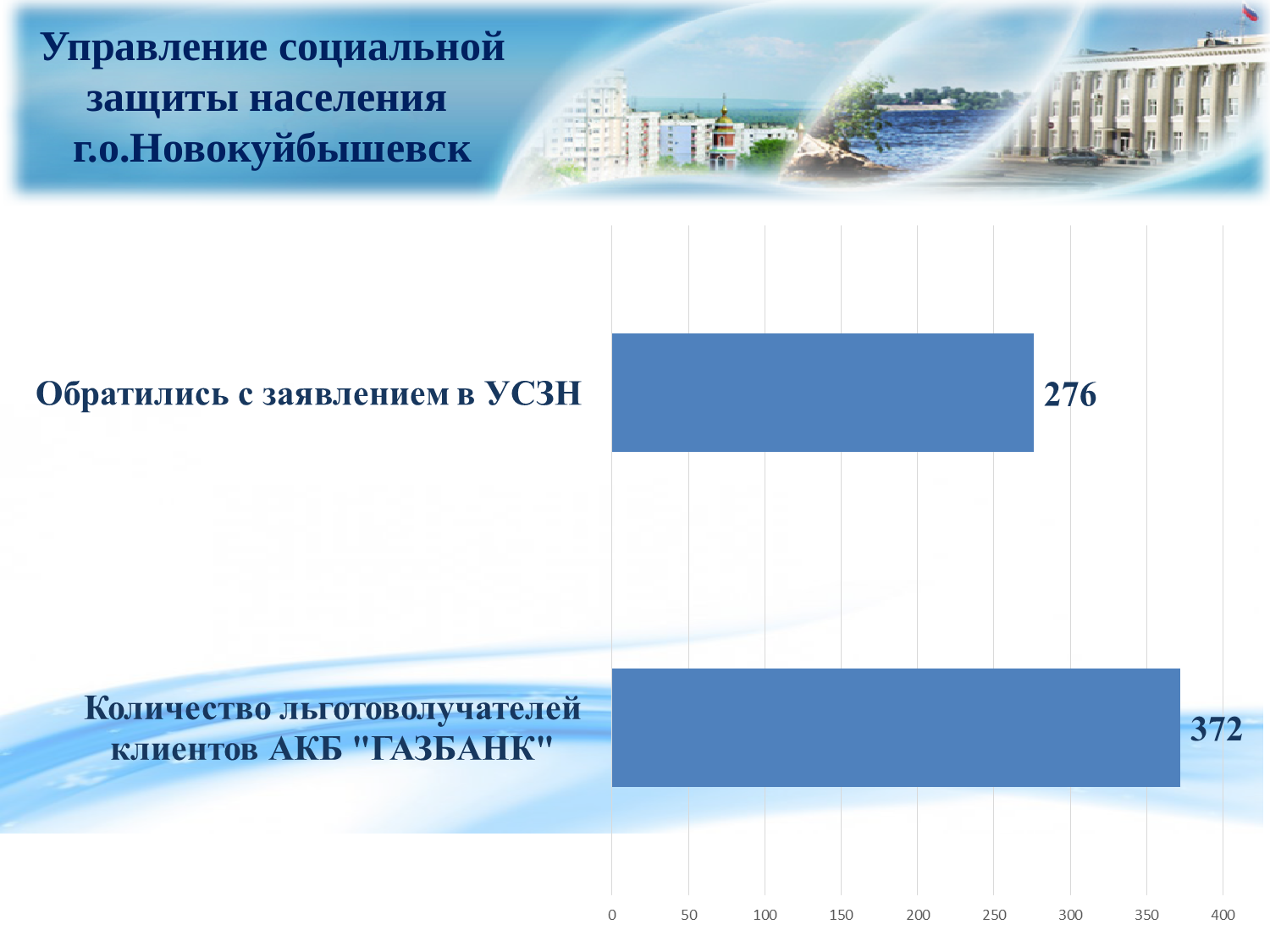
What is the value for "Количество льготополучателей клиентов АКБ "ГАЗБАНК""? 372 Which category has the highest value? Количество льготополучателей клиентов АКБ "ГАЗБАНК" Which category has the lowest value? Обратились с заявлением в УСЗН What kind of chart is shown on the slide? bar chart What is the difference between the value for "Количество льготополучателей клиентов АКБ "ГАЗБАНК"" and the value for "Обратились с заявлением в УСЗН"? 96 How many categories are shown in the chart? 2 Is the value for "Количество льготополучателей клиентов АКБ "ГАЗБАНК"" greater or less than 350? greater What is the value for "Обратились с заявлением в УСЗН"? 276 Is the value for "Обратились с заявлением в УСЗН" greater or less than 300? less What is the maximum value shown on the horizontal axis? 400 Which is larger: the value for "Обратились с заявлением в УСЗН" or the value for "Количество льготополучателей клиентов АКБ "ГАЗБАНК""? Количество льготополучателей клиентов АКБ "ГАЗБАНК" What colour are the bars in the chart? blue